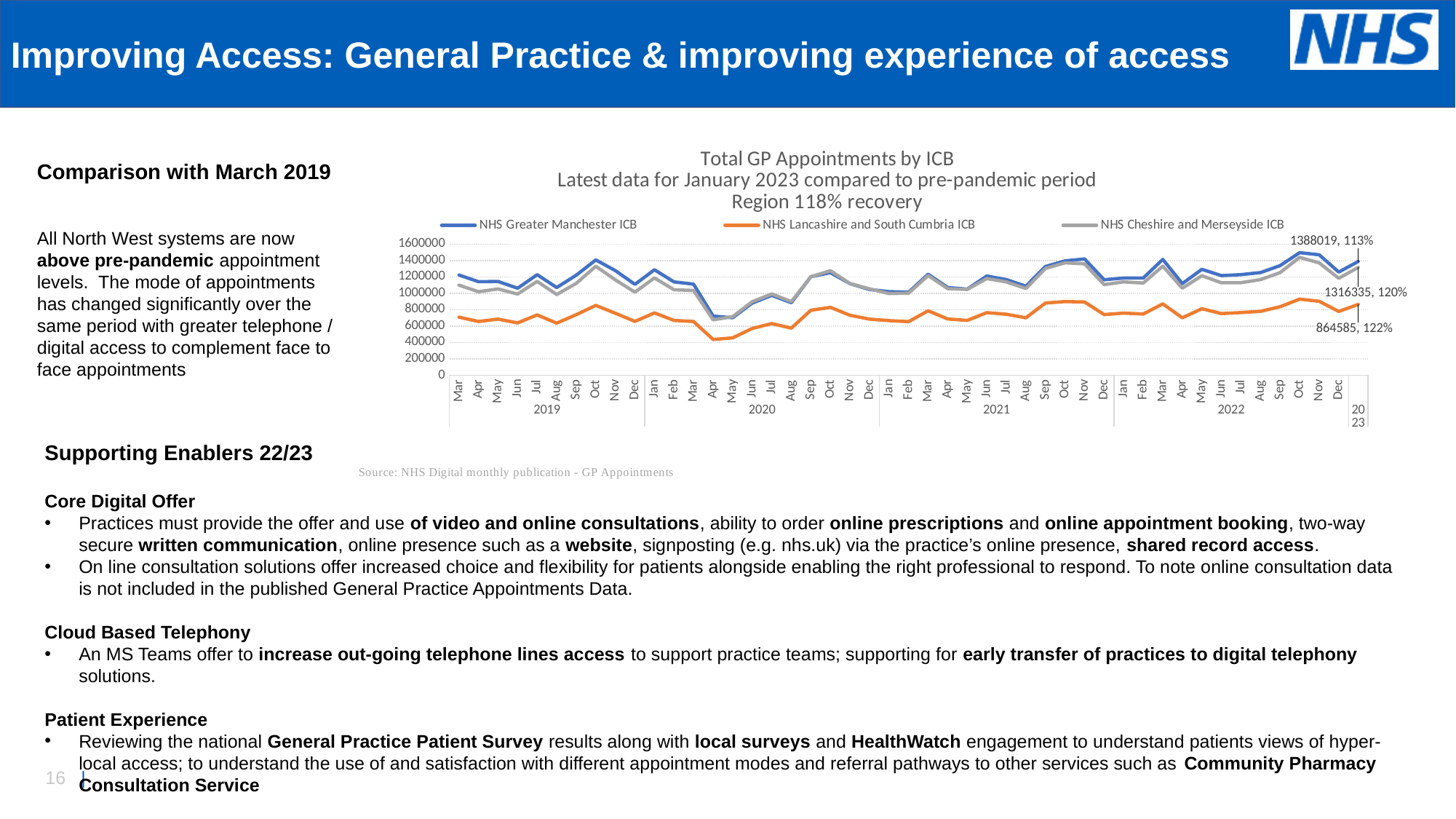
Is the value for NHS Lancashire and South Cumbria ICB in April 2020 greater or less than 600000? less According to the chart title, what is the regional recovery percentage? 118% Which ICB has the lowest line throughout the chart? NHS Lancashire and South Cumbria ICB What is the labelled value for NHS Greater Manchester ICB at the end of the series (January 2023)? 1388019 What is the difference between the January 2023 labelled values for NHS Greater Manchester ICB and NHS Cheshire and Merseyside ICB? 71684 What is the difference between the January 2023 labelled values for NHS Greater Manchester ICB and NHS Lancashire and South Cumbria ICB? 523434 Which is larger at January 2023: the value for NHS Greater Manchester ICB or NHS Cheshire and Merseyside ICB? NHS Greater Manchester ICB What kind of chart is shown on the slide? line chart What is the labelled value for NHS Lancashire and South Cumbria ICB at the end of the series (January 2023)? 864585 What is the labelled value for NHS Cheshire and Merseyside ICB at the end of the series (January 2023)? 1316335 What recovery percentage is shown in the data label for NHS Lancashire and South Cumbria ICB? 122% How many series does the legend of the chart list? 3